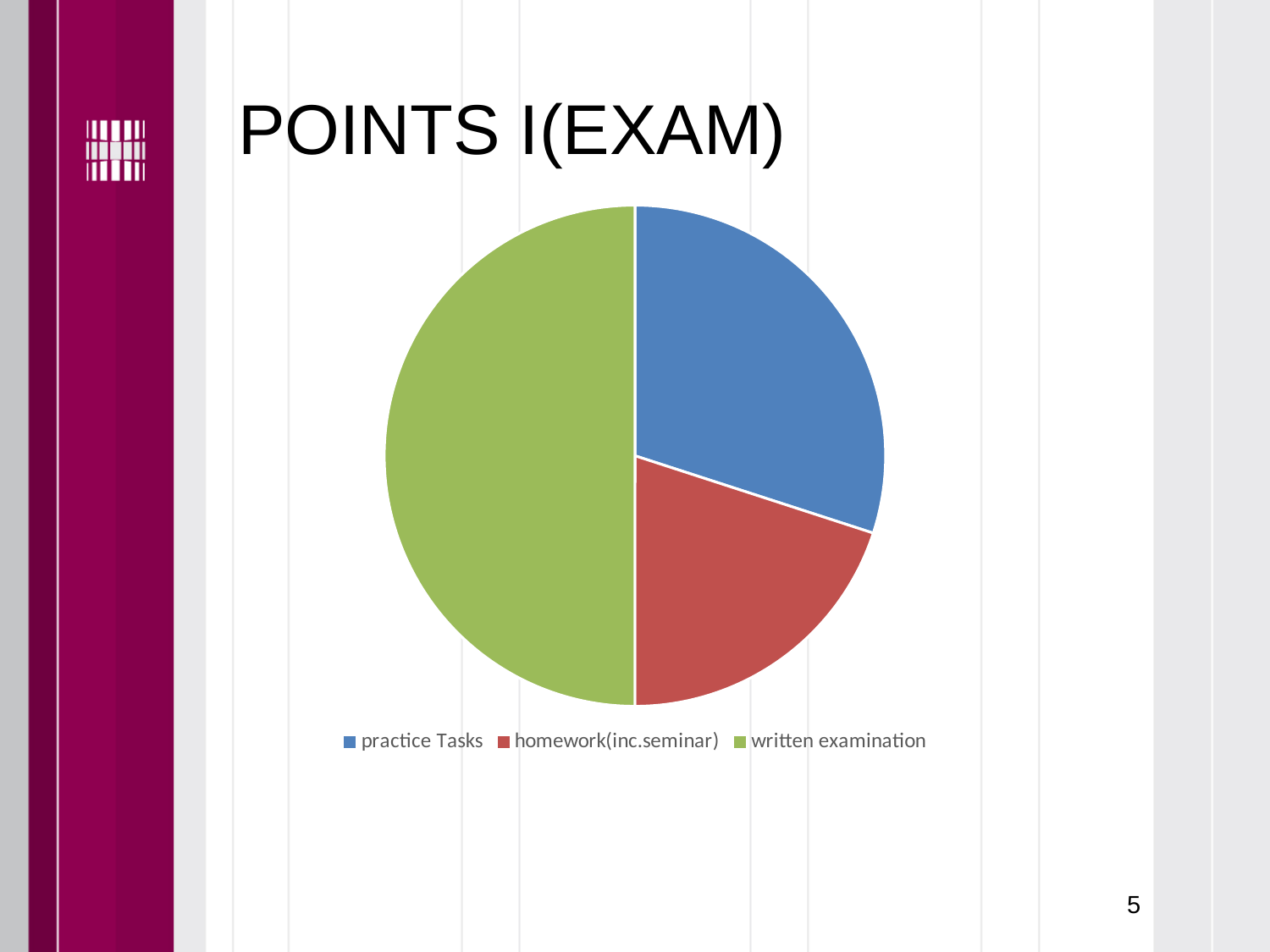
How many entries does the legend of the pie chart list? 3 What kind of chart is shown on the slide? pie chart Which slice is larger, written examination or homework(inc.seminar)? written examination Which slice is larger, practice Tasks or homework(inc.seminar)? practice Tasks Which slice is larger, written examination or practice Tasks? written examination Which category has the smallest slice of the pie chart? homework(inc.seminar) What colour is the written examination slice in the pie chart? green Which category has the largest slice of the pie chart? written examination How many slices does the pie chart have? 3 Which category is shown in blue in the pie chart? practice Tasks